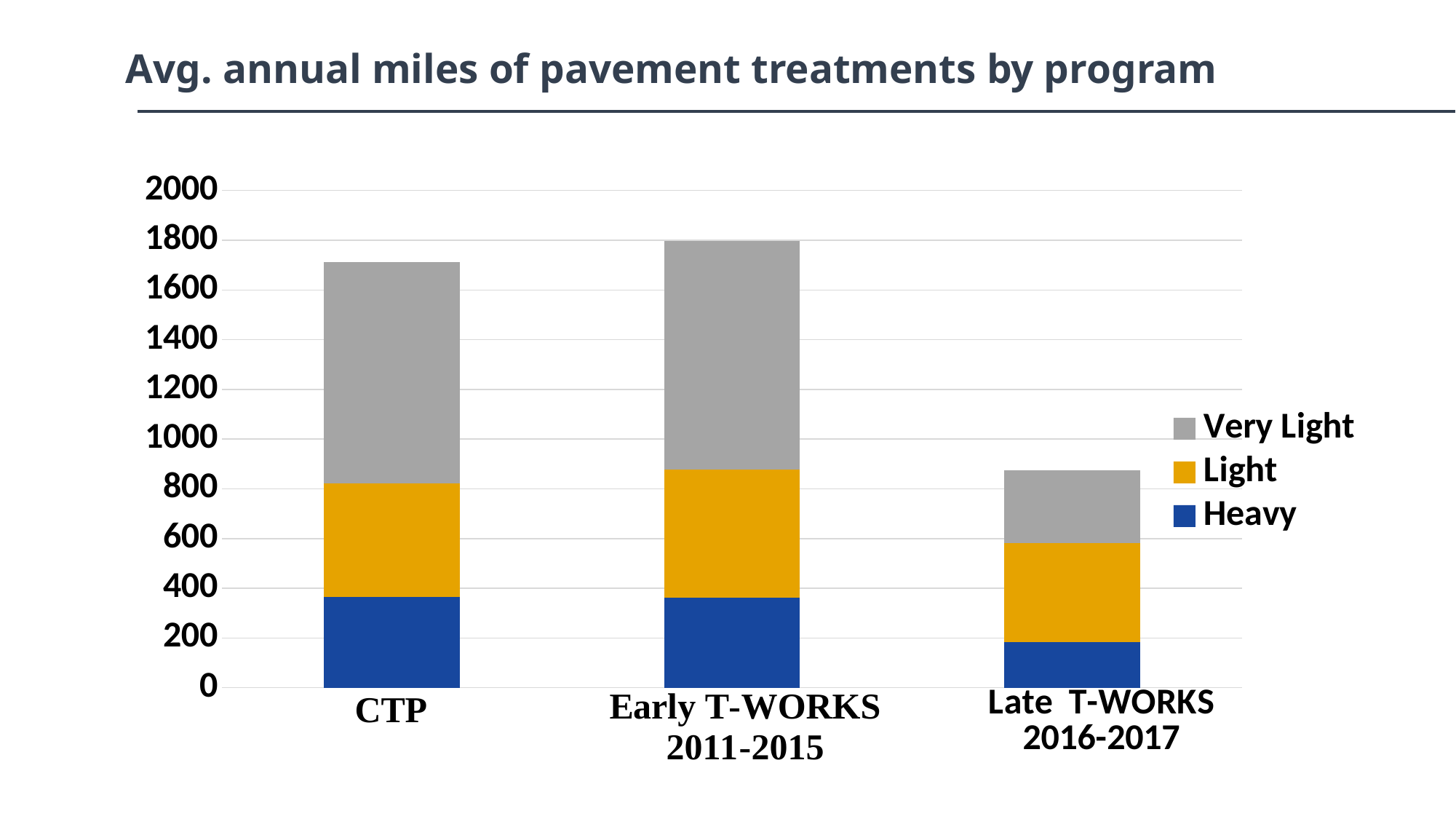
How many series does the legend list? 3 Is the total value for CTP greater or less than 1600? greater Which is larger: the Very Light segment for Early T-WORKS 2011-2015 or the Very Light segment for Late T-WORKS 2016-2017? Early T-WORKS 2011-2015 Do the total miles rise or fall from Early T-WORKS 2011-2015 to Late T-WORKS 2016-2017? fall Is the Heavy value for CTP greater or less than 200? greater What kind of chart is shown on the slide? bar chart How many programs (categories) are shown on the x axis? 3 Which program has the lowest total average annual miles of pavement treatments? Late T-WORKS 2016-2017 Which program has the highest total average annual miles of pavement treatments? Early T-WORKS 2011-2015 Which is larger: the Heavy segment for CTP or the Heavy segment for Late T-WORKS 2016-2017? CTP Is the total value for Late T-WORKS 2016-2017 greater or less than 1000? less Which colour represents the Heavy series in the legend? blue